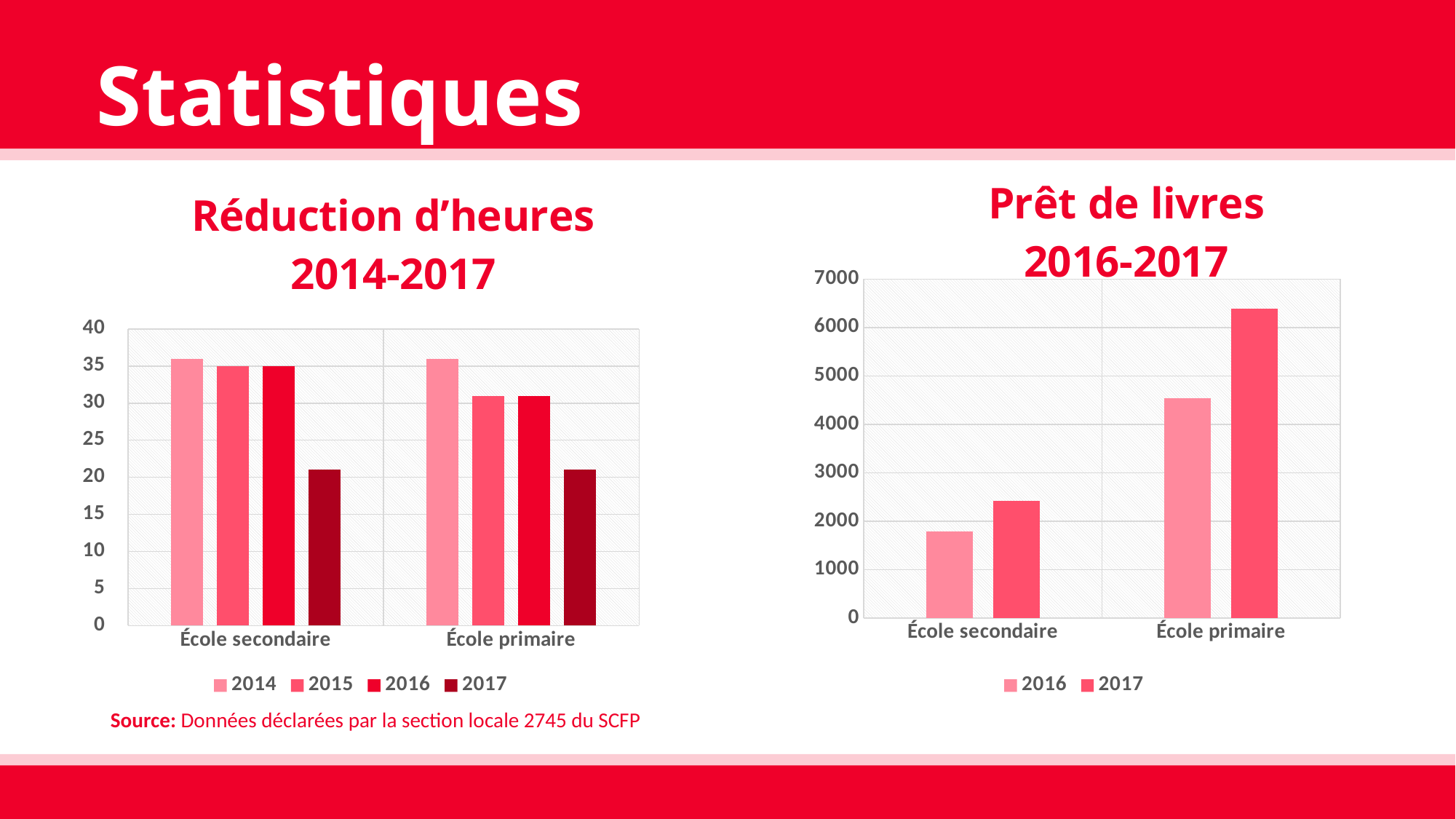
On the 'Réduction d'heures 2014-2017' chart, what kind of chart is shown? bar chart On the 'Réduction d'heures 2014-2017' chart, how many categories are shown on the x axis? 2 On the 'Prêt de livres 2016-2017' chart, is the 2016 value for École secondaire greater or less than 2000? less On the 'Réduction d'heures 2014-2017' chart, for École primaire, which is larger: the 2014 value or the 2015 value? 2014 On the 'Prêt de livres 2016-2017' chart, for École secondaire, which is larger: the 2016 value or the 2017 value? 2017 On the 'Réduction d'heures 2014-2017' chart, which series has the lowest value for École primaire? 2017 On the 'Réduction d'heures 2014-2017' chart, how many series does the legend list? 4 On the 'Prêt de livres 2016-2017' chart, is the 2017 value for École primaire greater or less than 6000? greater On the 'Prêt de livres 2016-2017' chart, which category has the highest bar? École primaire On the 'Réduction d'heures 2014-2017' chart, is the 2014 value for École primaire greater or less than 30? greater On the 'Prêt de livres 2016-2017' chart, how many series does the legend list? 2